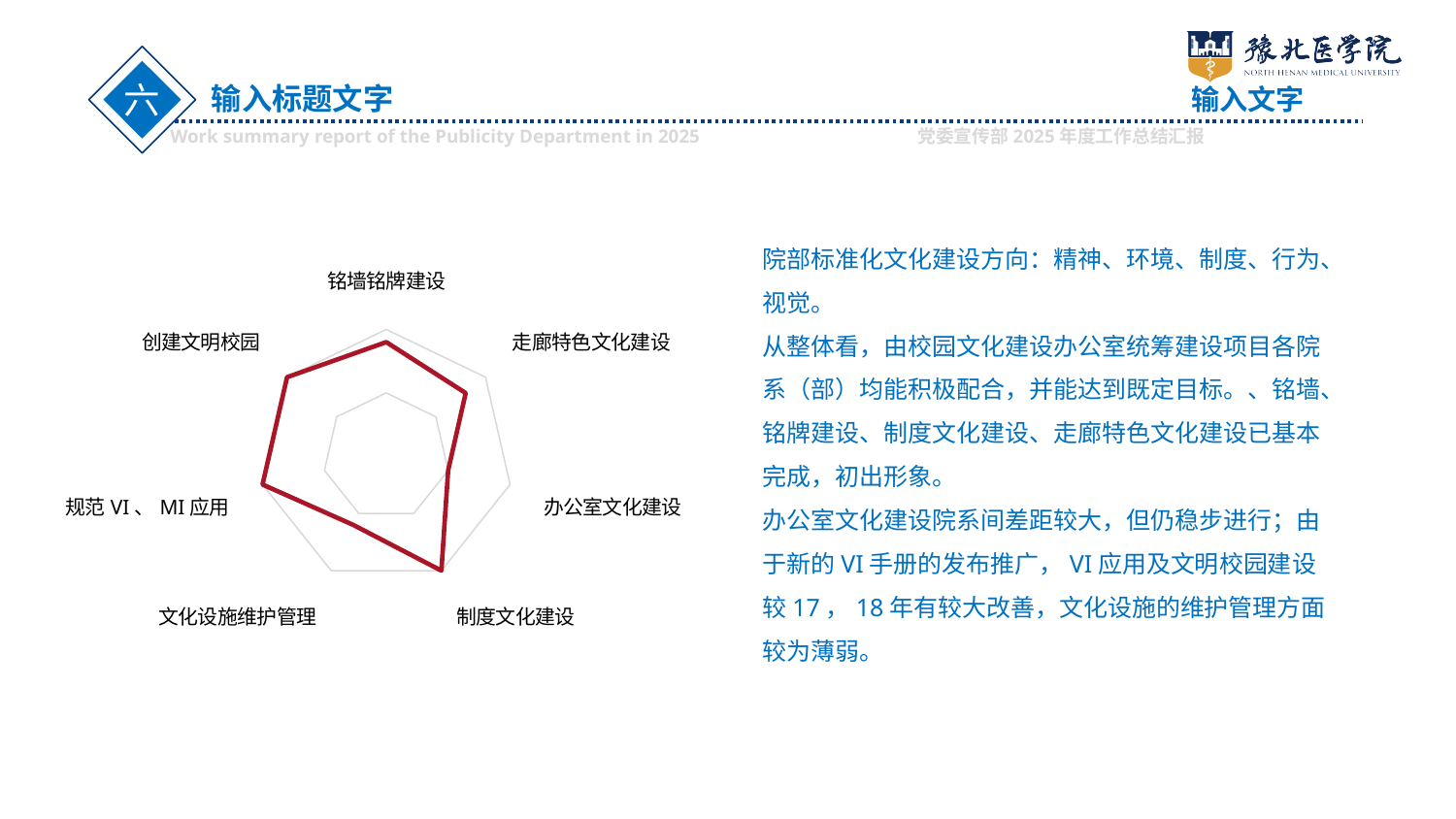
What colour is the data line plotted on the radar chart? Red What kind of chart is shown on the slide? Radar chart How many categories (axes) does the radar chart have? 7 Which is larger on the radar chart, the value for 制度文化建设 or the value for 办公室文化建设? 制度文化建设 Which category label appears at the top of the radar chart? 铭墙铭牌建设 Which is larger on the radar chart, the value for 走廊特色文化建设 or the value for 办公室文化建设? 走廊特色文化建设 Which category has the lowest value on the radar chart? 办公室文化建设 Which is larger on the radar chart, the value for 规范 VI、MI 应用 or the value for 文化设施维护管理? 规范 VI、MI 应用